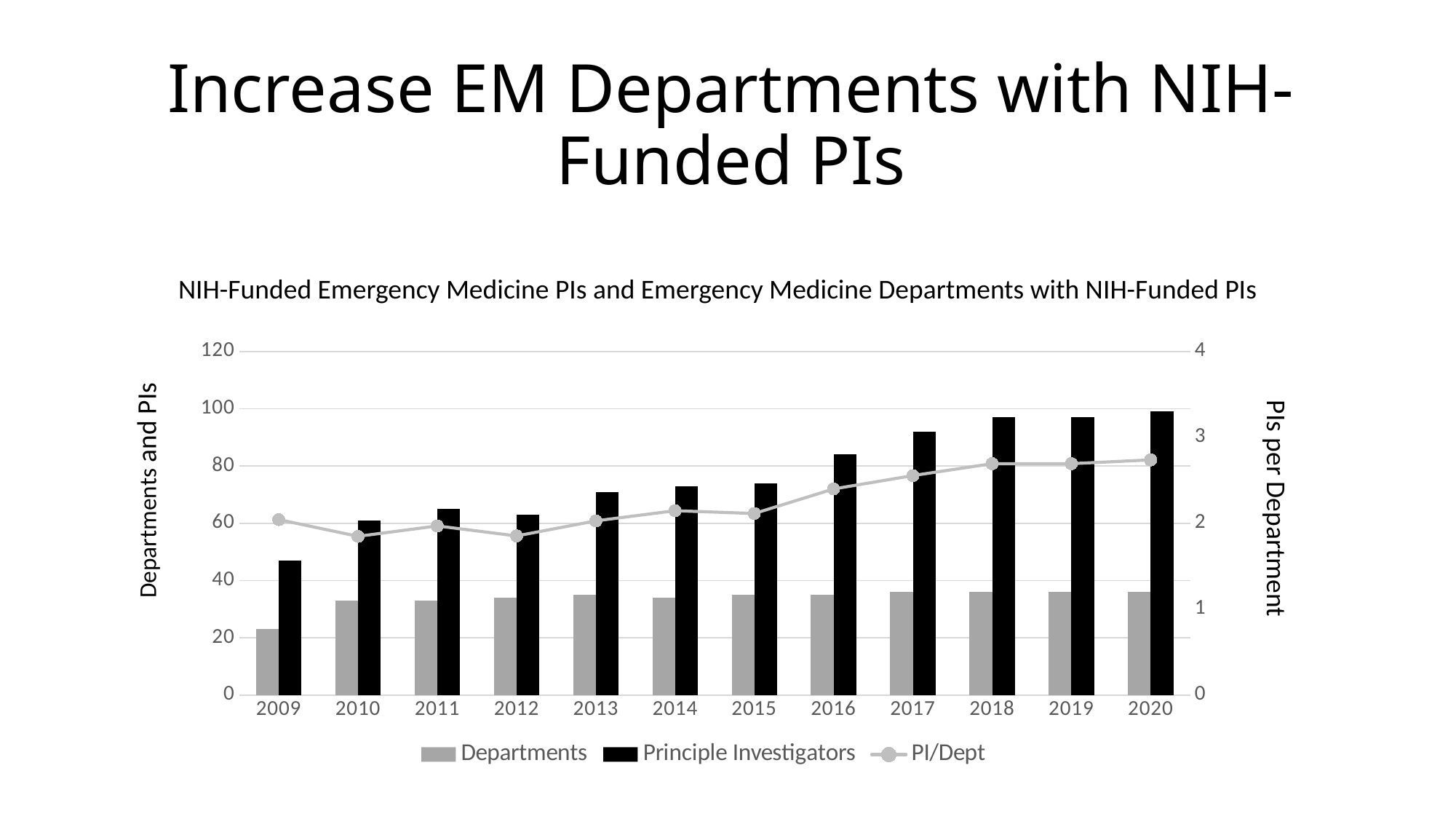
How many series does the legend list? 3 Is the PI/Dept value in 2020 greater or less than 2 on the right axis? greater Which year has the lowest value for Principle Investigators? 2009 Do the Principle Investigators values generally rise or fall from 2009 to 2020? rise Which is larger, the Departments value in 2009 or in 2010? 2010 What is the label of the right-hand vertical axis? PIs per Department Is the value for Departments in 2020 greater or less than 40? less Which year has the lowest value for Departments? 2009 Which is larger, the Principle Investigators value in 2013 or in 2017? 2017 Is the value for Principle Investigators in 2017 greater or less than 80? greater How many years are shown on the x axis? 12